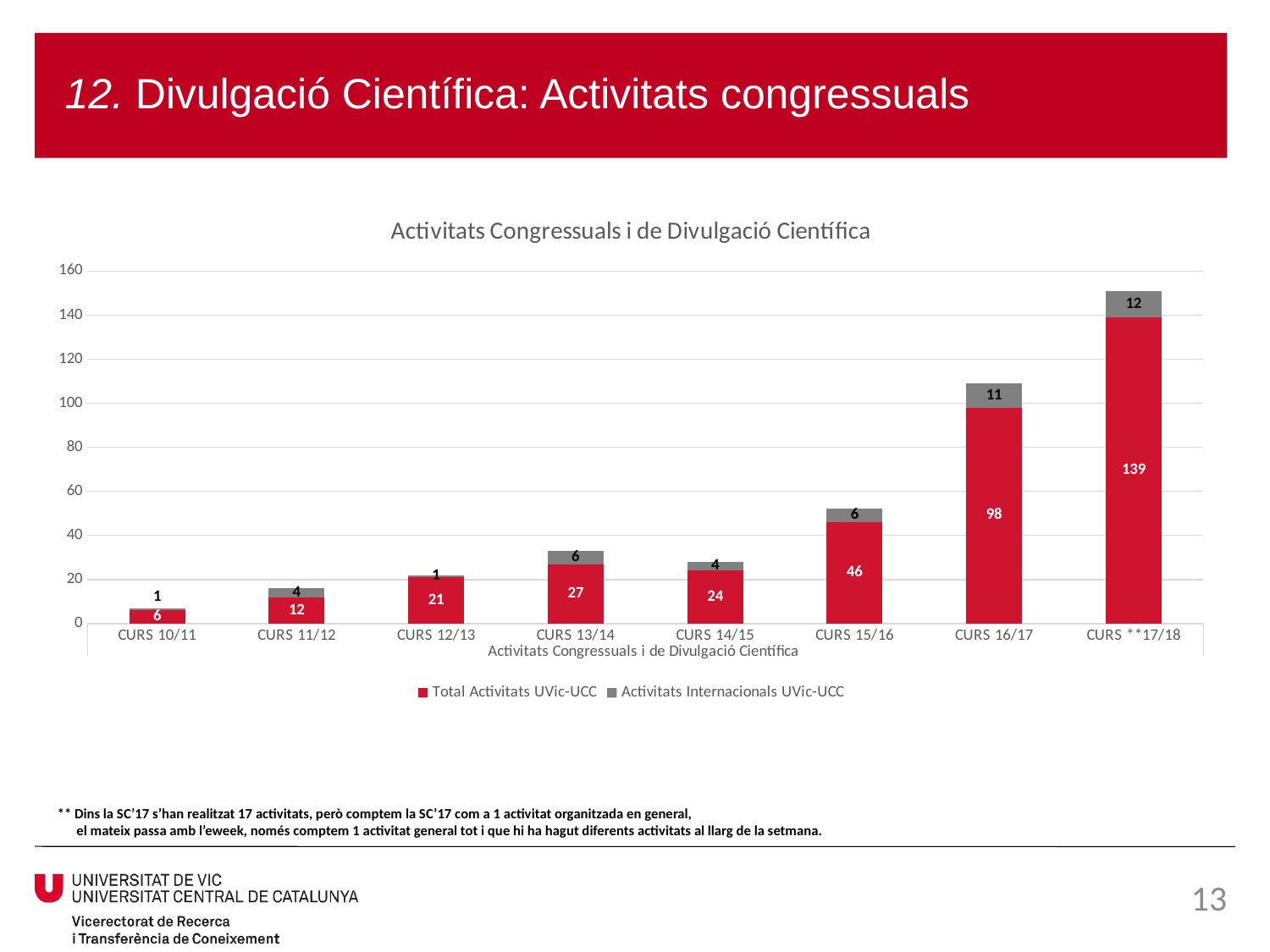
What is the total of the stacked bar for CURS 15/16? 52 What is the value of Total Activitats UVic-UCC for CURS 16/17? 98 What is the value of Total Activitats UVic-UCC for CURS 14/15? 24 What is the value of Activitats Internacionals UVic-UCC for CURS 13/14? 6 What is the title of the chart? Activitats Congressuals i de Divulgació Científica What type of chart is shown on the slide? bar chart Which category has the highest value for Total Activitats UVic-UCC? CURS **17/18 What is the difference between Total Activitats UVic-UCC for CURS **17/18 and CURS 16/17? 41 Which category has the lowest value for Total Activitats UVic-UCC? CURS 10/11 How many series does the legend list? 2 Which is larger, Total Activitats UVic-UCC for CURS 13/14 or for CURS 14/15? CURS 13/14 How many categories are shown on the x axis? 8